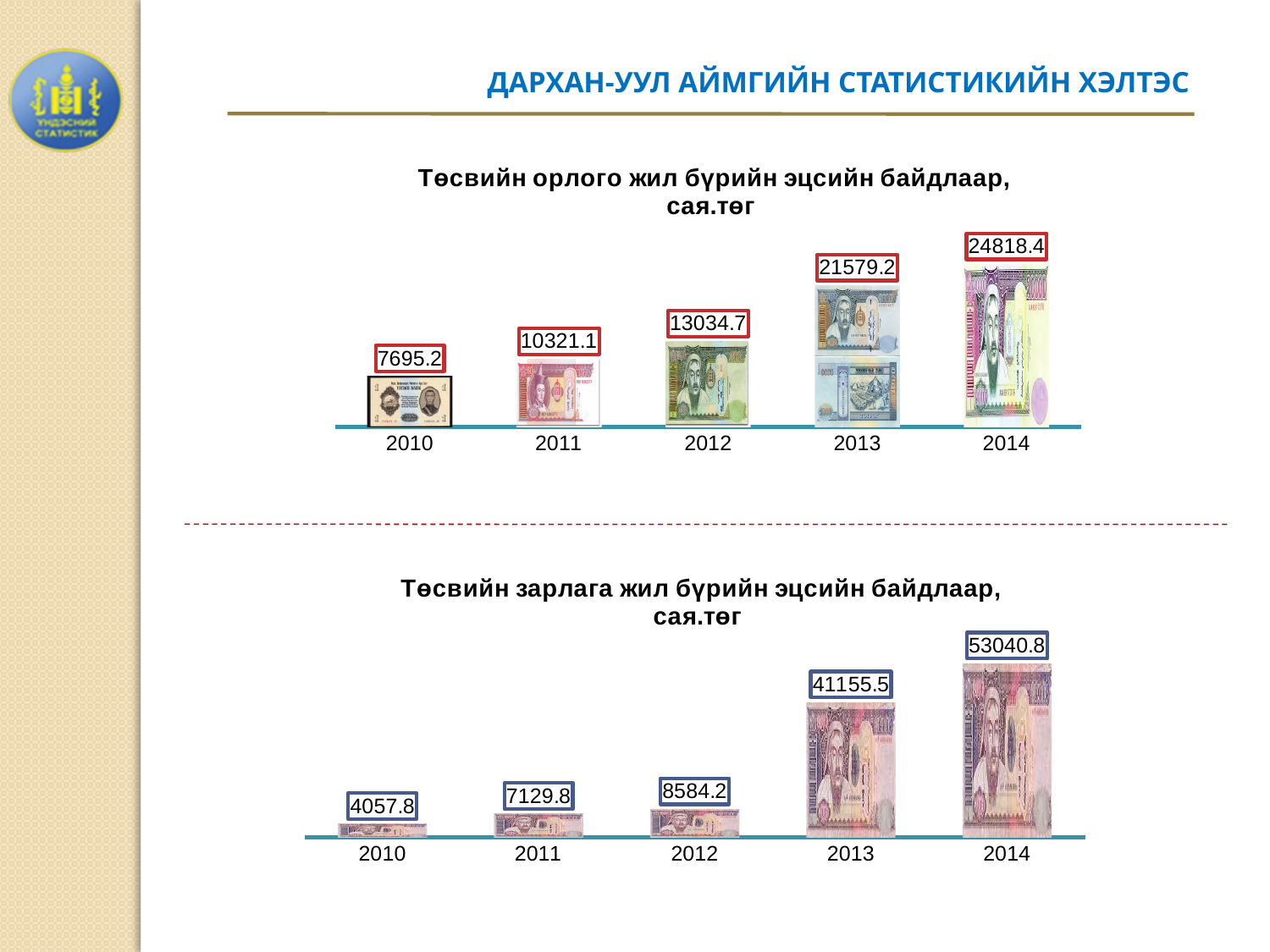
What kind of chart is the bottom chart (Төсвийн зарлага)? bar chart In the top chart (Төсвийн орлого), do the values rise or fall from 2010 to 2014? rise In the top chart (Төсвийн орлого), what is the value for 2010? 7695.2 In the top chart (Төсвийн орлого), which year has the highest value? 2014 How many years are shown on the x axis of the top chart (Төсвийн орлого)? 5 In the top chart (Төсвийн орлого), what is the difference between the 2014 and 2013 values? 3239.2 In the bottom chart (Төсвийн зарлага), which is larger, the value for 2012 or the value for 2013? 2013 What unit is stated in the title of the bottom chart? сая.төг In the bottom chart (Төсвийн зарлага), what is the difference between the 2014 and 2013 values? 11885.3 In the bottom chart (Төсвийн зарлага), what is the value for 2011? 7129.8 In the bottom chart (Төсвийн зарлага), which year has the lowest value? 2010 In the top chart (Төсвийн орлого), what is the value for 2012? 13034.7